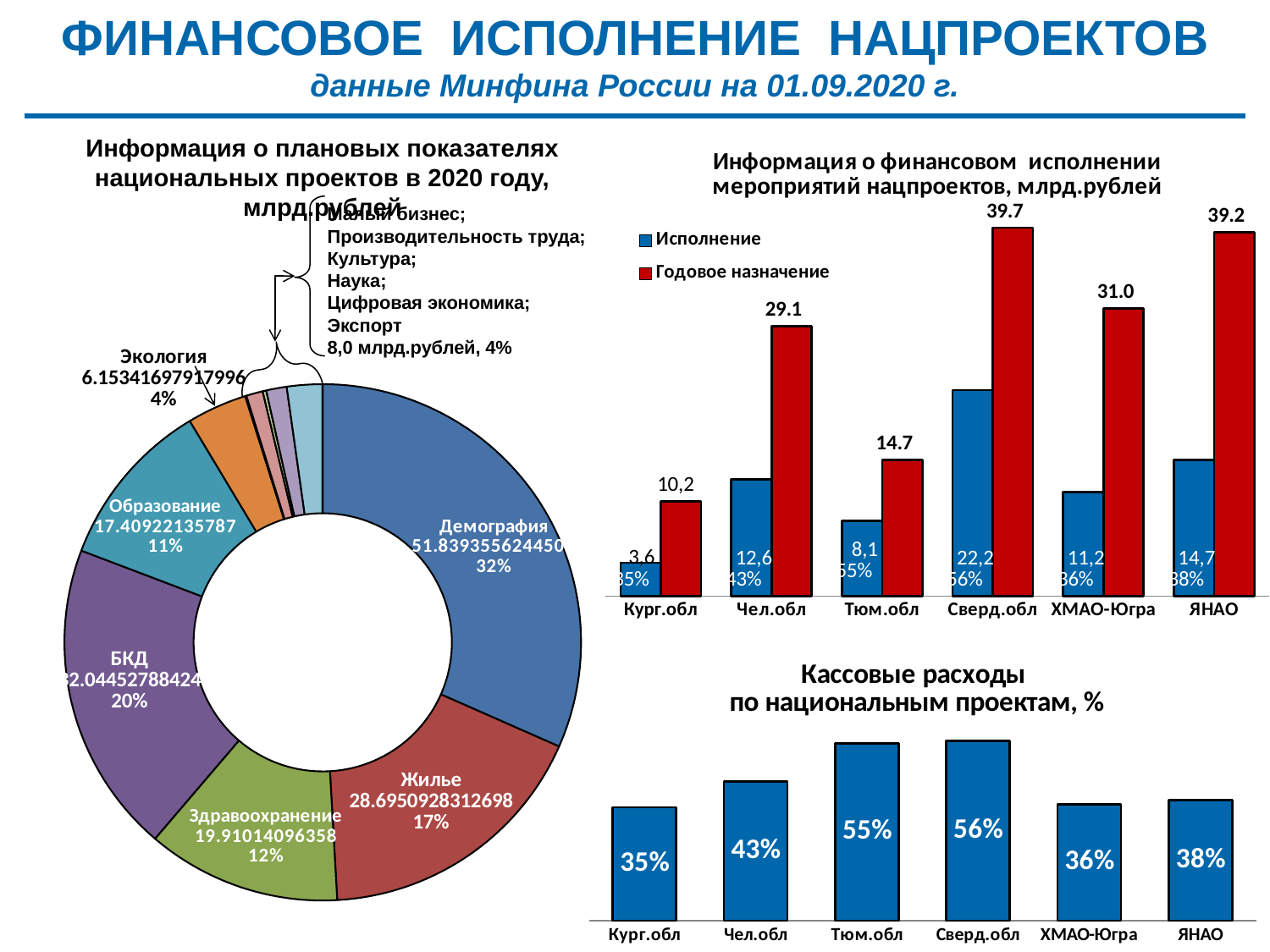
In the chart 'Информация о финансовом исполнении мероприятий нацпроектов, млрд.рублей', what is the Годовое назначение value for Сверд.обл? 39.7 In the chart 'Информация о финансовом исполнении мероприятий нацпроектов, млрд.рублей', what is the Исполнение value for Чел.обл? 12,6 In the chart 'Информация о плановых показателях национальных проектов в 2020 году, млрд.рублей', what share does Демография have? 32% In the chart 'Информация о плановых показателях национальных проектов в 2020 году, млрд.рублей', which category has the largest share? Демография In the chart 'Кассовые расходы по национальным проектам, %', which region has the highest value? Сверд.обл In the chart 'Кассовые расходы по национальным проектам, %', how many regions are shown? 6 In the chart 'Информация о финансовом исполнении мероприятий нацпроектов, млрд.рублей', which has the larger Годовое назначение value, ХМАО-Югра or Чел.обл? ХМАО-Югра In the chart 'Кассовые расходы по национальным проектам, %', which region has the lowest value? Кург.обл In the chart 'Информация о финансовом исполнении мероприятий нацпроектов, млрд.рублей', what is the difference between Годовое назначение and Исполнение for ЯНАО? 24.5 In the chart 'Информация о финансовом исполнении мероприятий нацпроектов, млрд.рублей', what kind of chart is it? bar chart In the chart 'Кассовые расходы по национальным проектам, %', what is the value for Тюм.обл? 55% In the chart 'Информация о финансовом исполнении мероприятий нацпроектов, млрд.рублей', how many series does the legend list? 2